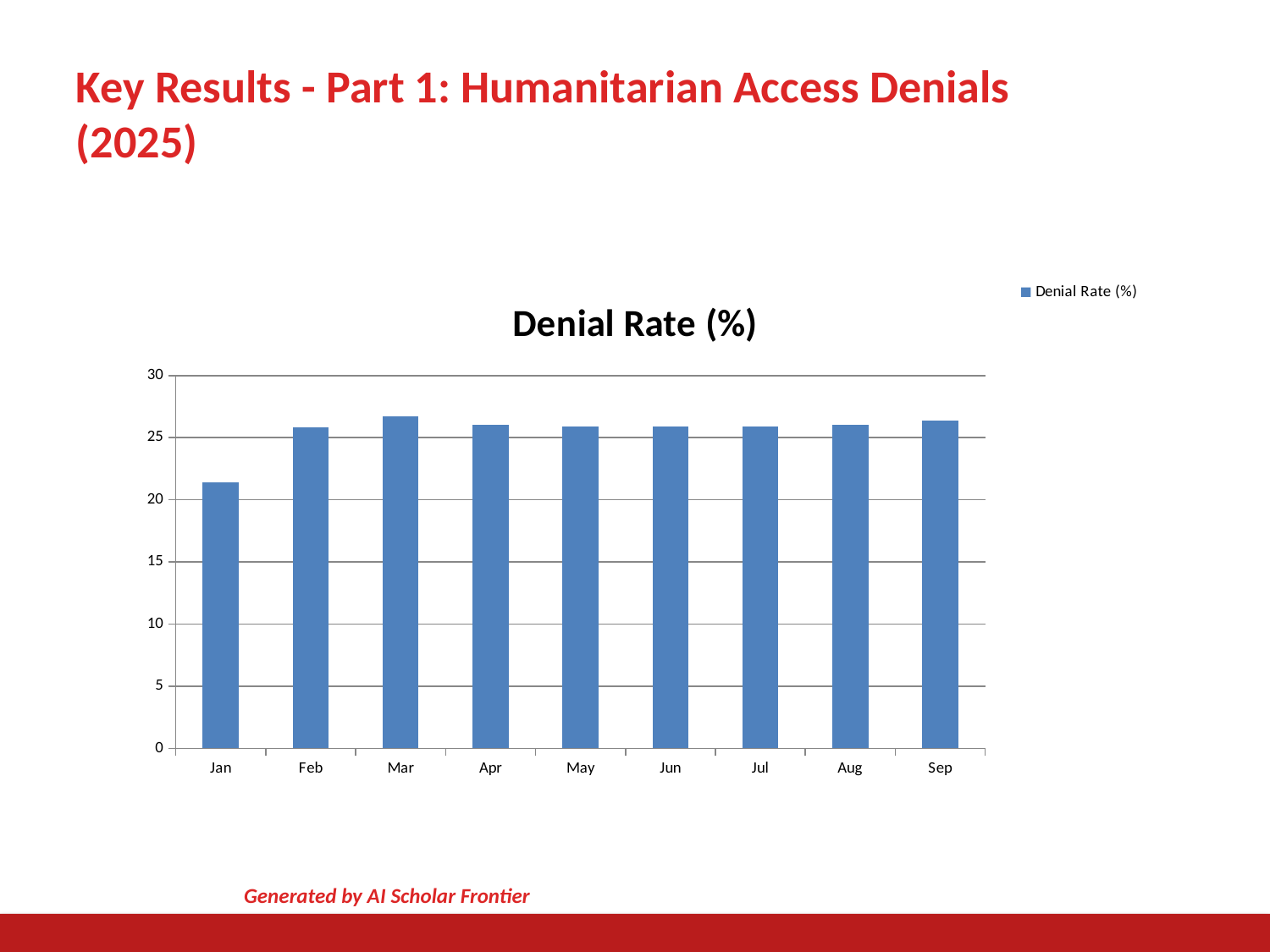
Is the value for Jan greater or less than 25? less What is the title of the chart? Denial Rate (%) Is the value for Mar greater or less than 25? greater Which is larger, the value for Jan or the value for Sep? Sep Is the value for Sep greater or less than 30? less What type of chart is shown on the slide? bar chart How many series does the chart's legend list? 1 What is the name of the series shown in the legend? Denial Rate (%) How many months are shown on the x axis of the chart? 9 Which month has the lowest denial rate? Jan Which is larger, the value for Jan or the value for Feb? Feb